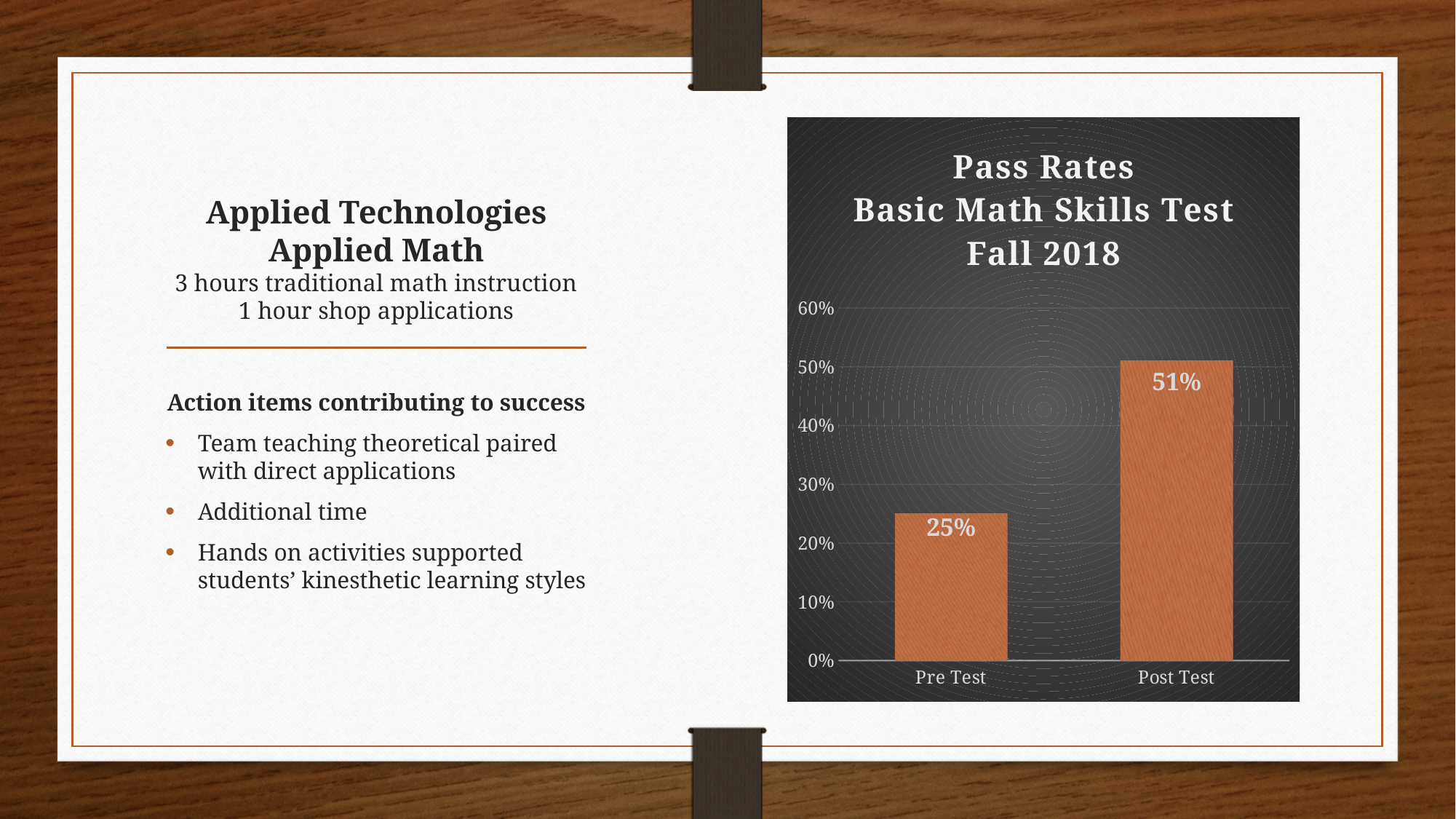
Do the values rise or fall from Pre Test to Post Test? Rise Which category has the highest pass rate? Post Test Which is larger, the Pre Test pass rate or the Post Test pass rate? Post Test What is the pass rate for the Post Test? 51% Is the value for Post Test greater or less than 40%? greater Is the value for Pre Test greater or less than 30%? less What is the title of the chart? Pass Rates Basic Math Skills Test Fall 2018 Which category has the lowest pass rate? Pre Test What is the difference between the Post Test and Pre Test pass rates? 26% What kind of chart is shown on the slide? Bar chart What is the pass rate for the Pre Test? 25% How many categories are shown on the chart? 2